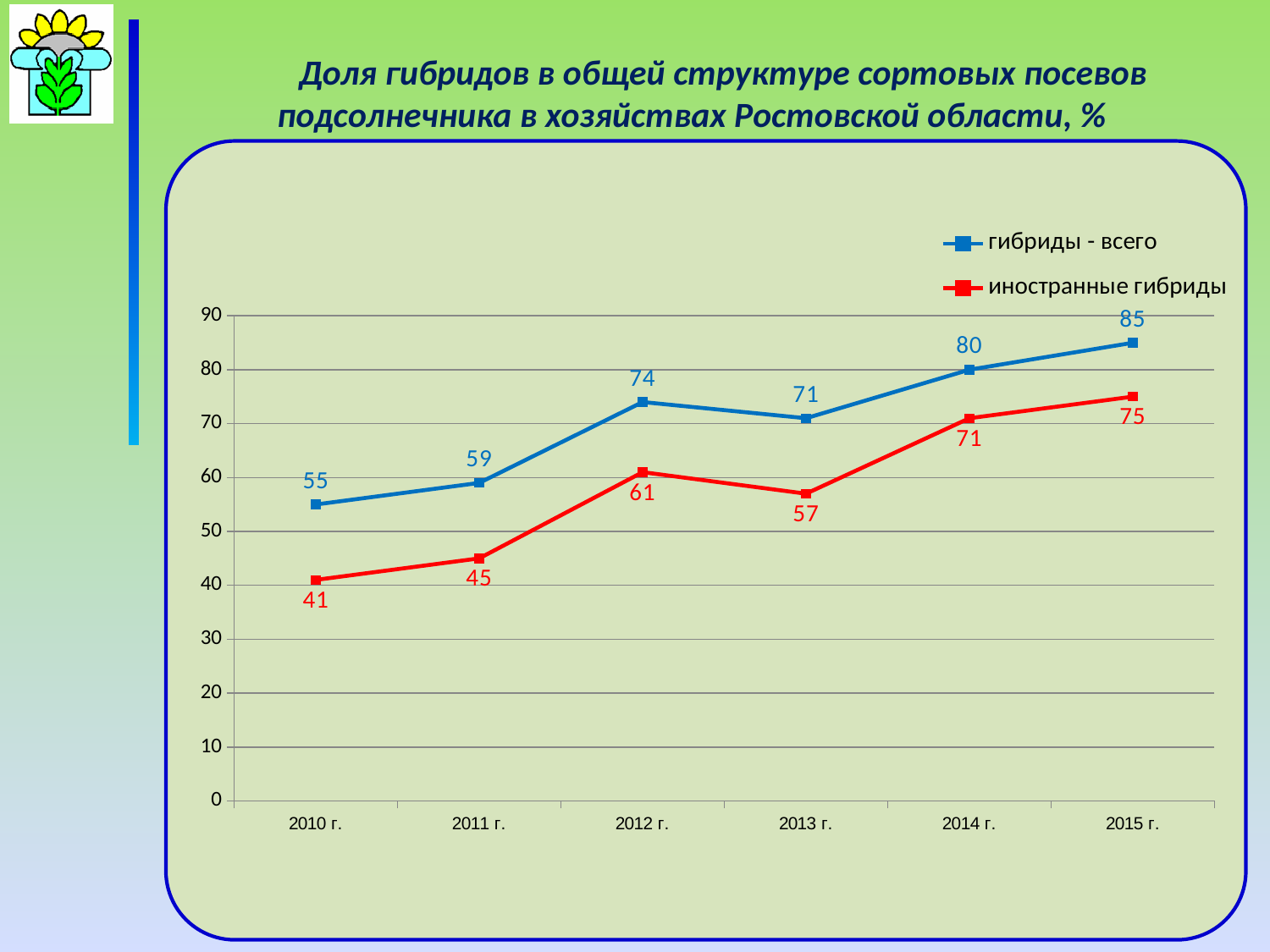
What is the value for "иностранные гибриды" in 2010 г.? 41 How many series does the legend list? 2 In which year is the value for "гибриды - всего" highest? 2015 г. What is the difference between "гибриды - всего" and "иностранные гибриды" in 2013 г.? 14 Which is larger: "иностранные гибриды" in 2012 г. or "иностранные гибриды" in 2013 г.? 2012 г. How many years are shown on the x axis? 6 Does the value for "гибриды - всего" rise or fall from 2012 г. to 2013 г.? fall By how much did the value for "гибриды - всего" change from 2010 г. to 2015 г.? 30 What is the value for "гибриды - всего" in 2012 г.? 74 What is the value for "иностранные гибриды" in 2014 г.? 71 What kind of chart is shown on the slide? line chart In which year is the value for "иностранные гибриды" lowest? 2010 г.